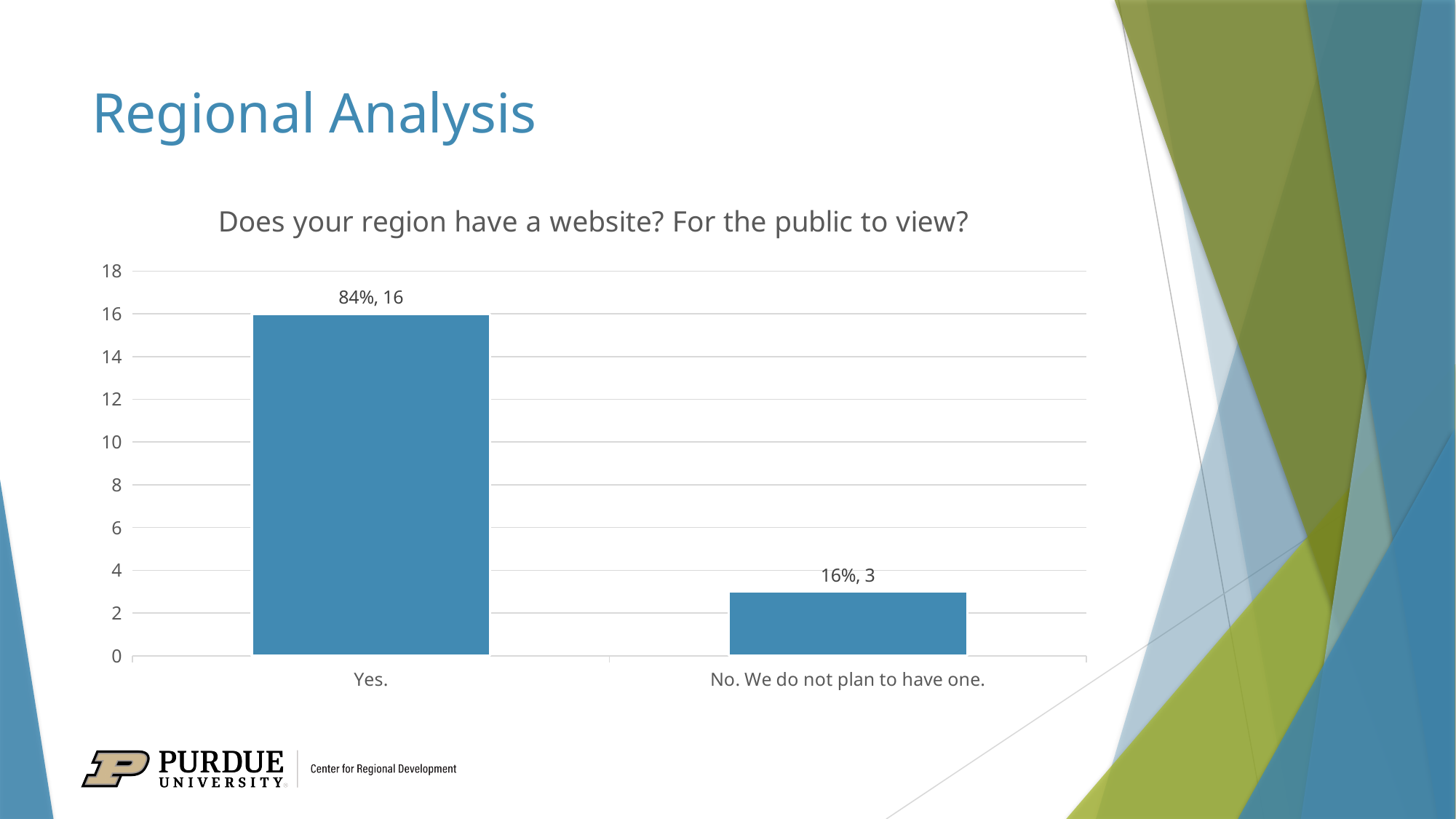
What is the difference in count between "Yes." and "No. We do not plan to have one."? 13 Is the value for "Yes." greater or less than 10? greater How many categories are shown on the x axis? 2 Which category has the lowest value? No. We do not plan to have one. What is the count for the "Yes." category? 16 What kind of chart is shown on the slide? bar chart What percentage is shown for the "Yes." category? 84% What is the title of the chart? Does your region have a website? For the public to view? What is the count for the "No. We do not plan to have one." category? 3 Which is larger, the value for "Yes." or the value for "No. We do not plan to have one."? Yes. What percentage is shown for the "No. We do not plan to have one." category? 16% Which category has the highest value? Yes.